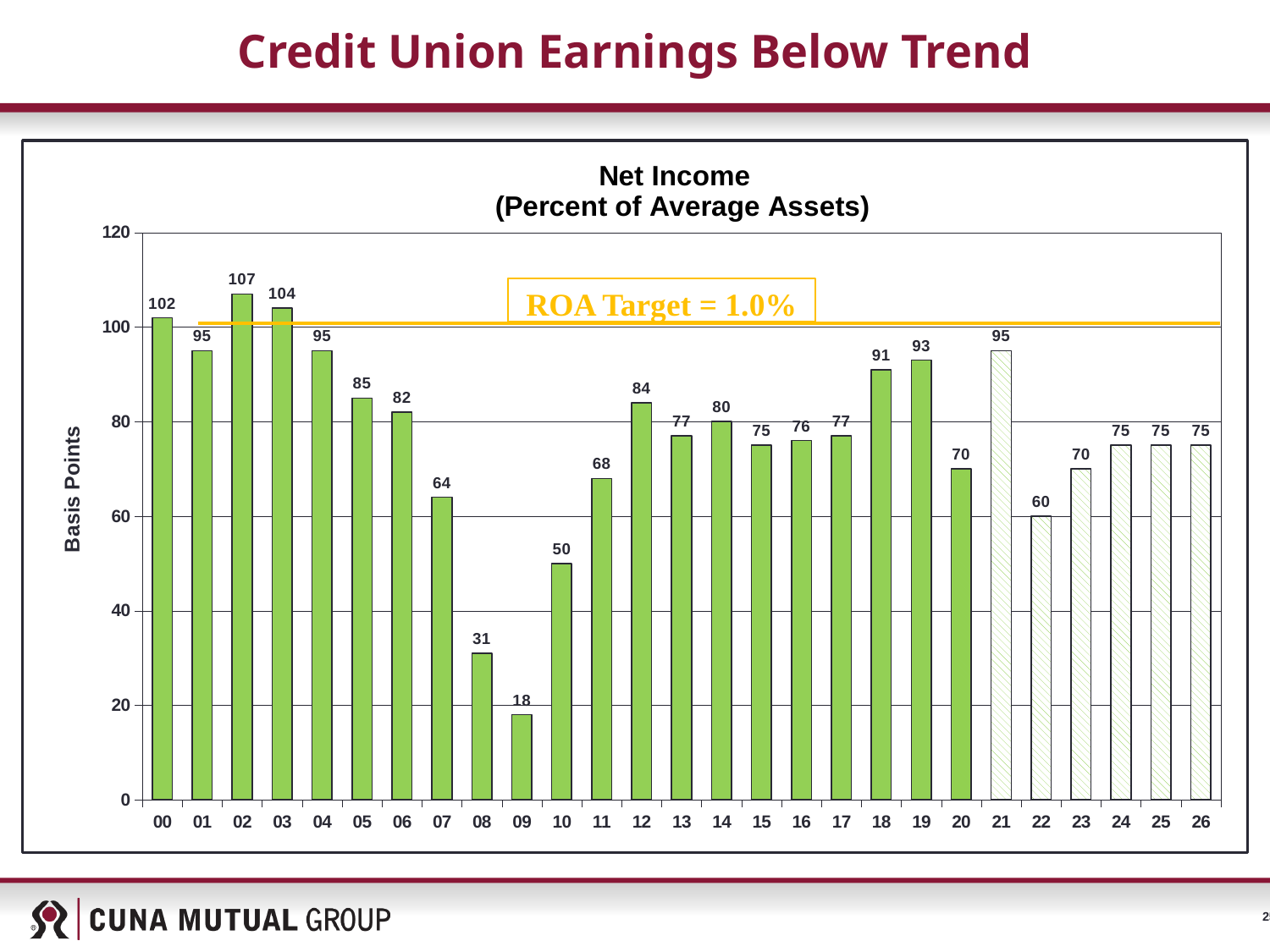
What is the label on the y axis? Basis Points What is the value for 09? 18 Which year has the lowest value? 09 What is the value for 19? 93 What kind of chart is shown? Bar chart What is the difference between the values for 02 and 09? 89 Which year has the highest value? 02 Do the values rise or fall from 05 to 09? Fall Which is larger, the value for 12 or the value for 14? 12 What is the difference between the values for 18 and 20? 21 How many bars are plotted in the chart? 27 What is the value for 22? 60